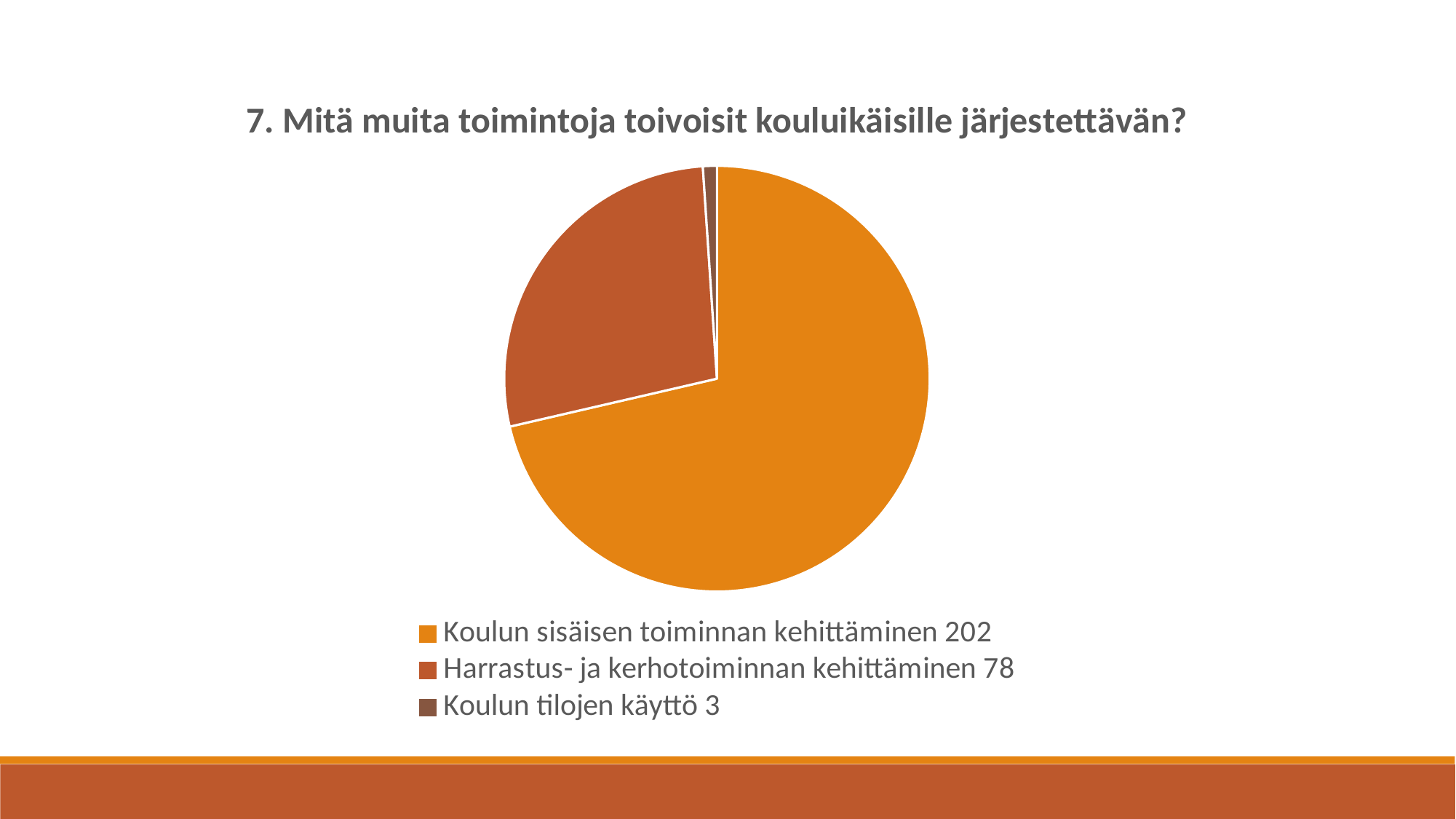
What kind of chart is shown on the slide? pie chart How many categories does the pie chart have? 3 Which category has the smallest slice of the pie? Koulun tilojen käyttö What is the difference between the values for Harrastus- ja kerhotoiminnan kehittäminen and Koulun tilojen käyttö? 75 What is the difference between the values for Koulun sisäisen toiminnan kehittäminen and Harrastus- ja kerhotoiminnan kehittäminen? 124 What is the value for Harrastus- ja kerhotoiminnan kehittäminen? 78 What is the title of the chart? 7. Mitä muita toimintoja toivoisit kouluikäisille järjestettävän? Which category has the largest slice of the pie? Koulun sisäisen toiminnan kehittäminen What is the value for Koulun tilojen käyttö? 3 Which is larger, the value for Harrastus- ja kerhotoiminnan kehittäminen or the value for Koulun tilojen käyttö? Harrastus- ja kerhotoiminnan kehittäminen What is the value for Koulun sisäisen toiminnan kehittäminen? 202 What is the total of all the values shown in the pie chart? 283